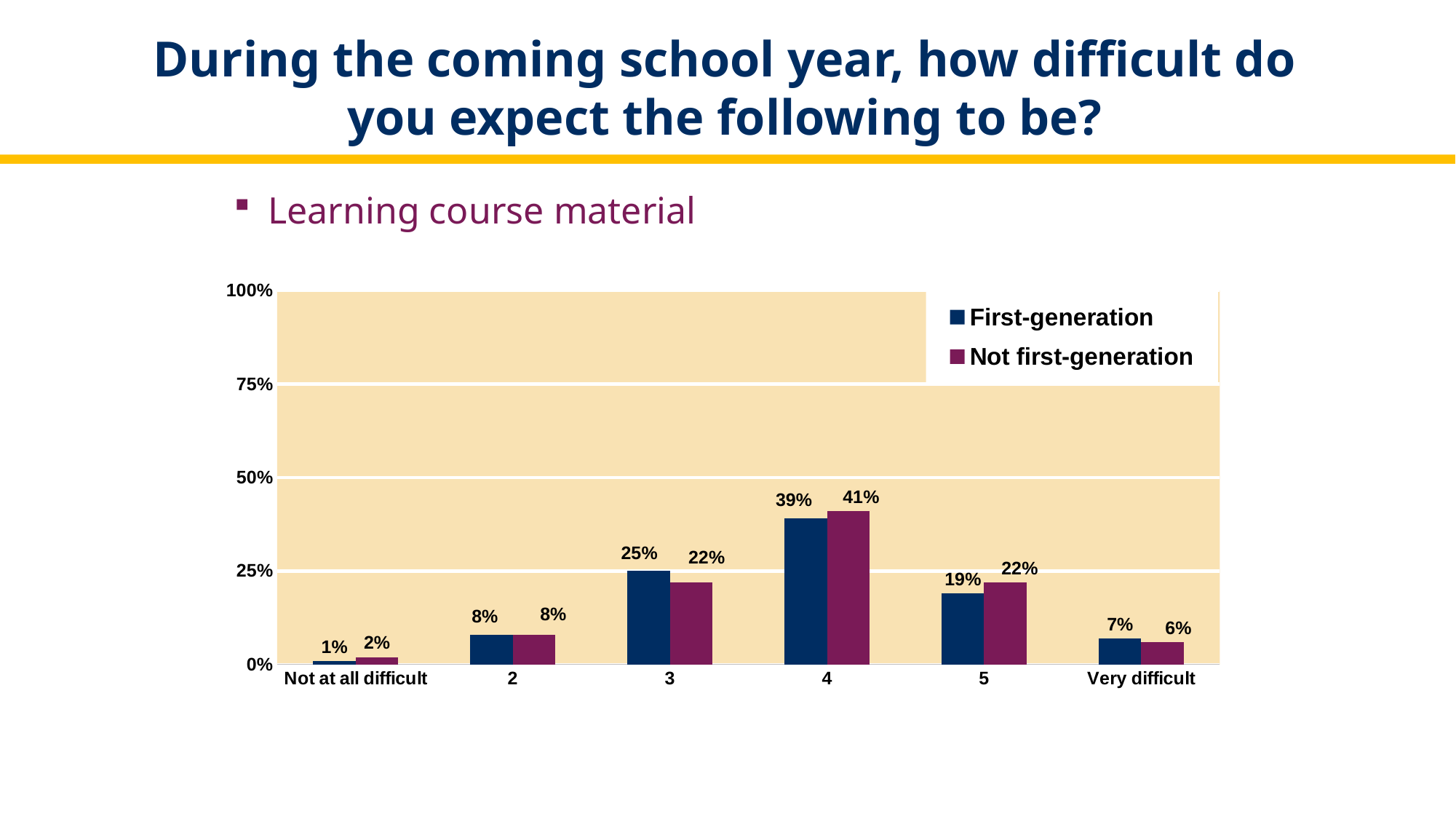
What kind of chart is shown on the slide? Bar chart How many series does the legend list? 2 Which series is shown in dark blue? First-generation What is the value for Not first-generation at 'Very difficult'? 6% Is the value for First-generation at category 4 greater or less than 25%? greater What is the difference between the Not first-generation and First-generation values at category 5? 3% Which category has the lowest value for the First-generation series? Not at all difficult What is the value for Not first-generation at category 3? 22% At category 3, which series has the larger value, First-generation or Not first-generation? First-generation Which category has the highest value for the Not first-generation series? 4 How many categories are shown on the x axis? 6 What is the value for First-generation at category 4? 39%